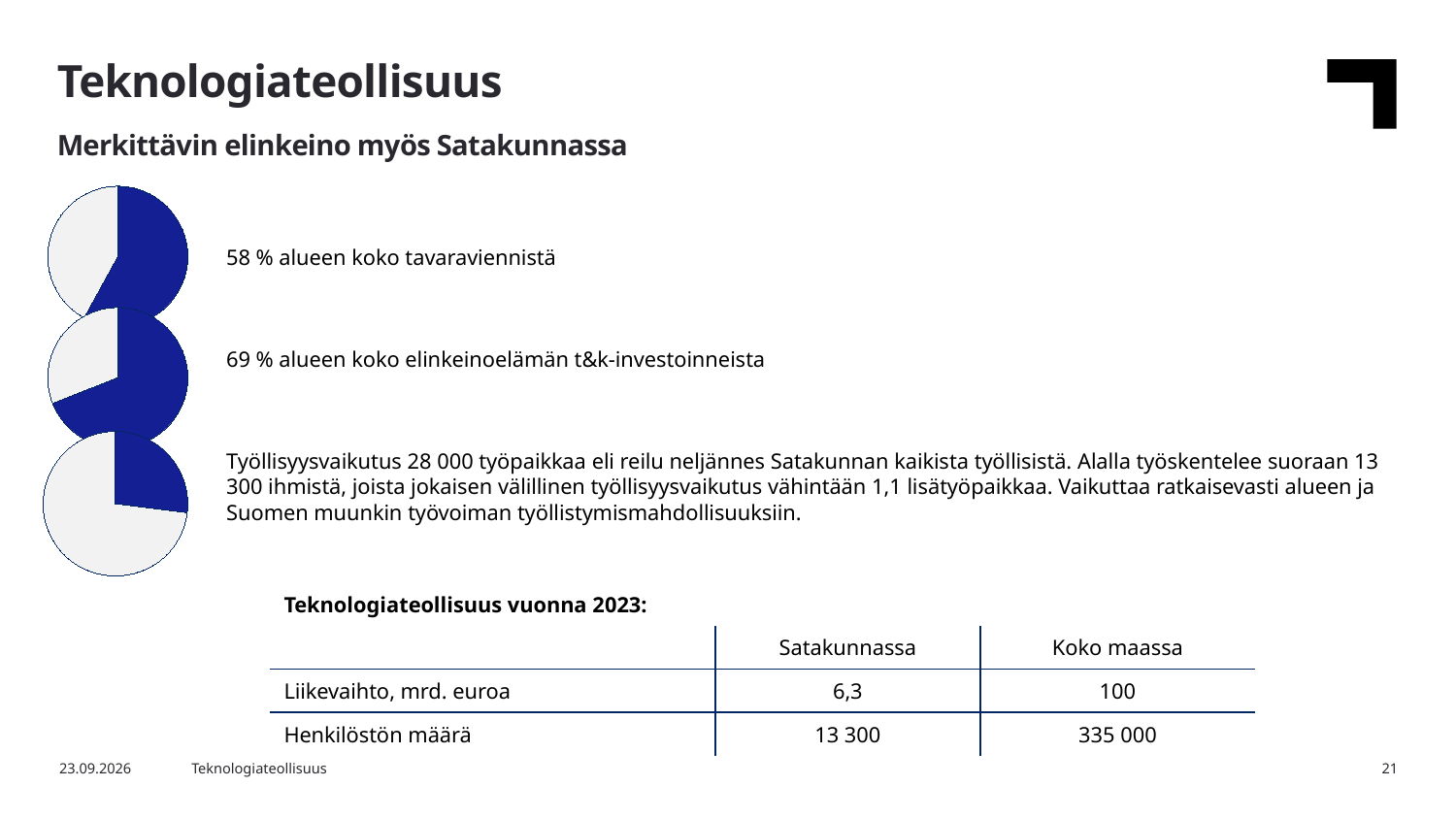
In the top pie chart, what share of the region's total goods exports does the blue slice represent, according to the text beside it? 58 % Is the blue slice in the bottom pie chart greater or less than half of the pie? less What kind of charts are shown on the left side of the slide? Pie charts Which pie chart has the largest blue slice: the top, middle or bottom one? Middle What colour is the highlighted slice in each pie chart? Blue Is the blue slice in the bottom pie chart larger or smaller than the blue slice in the top pie chart? Smaller How many slices does each pie chart have? 2 Is the blue slice in the middle pie chart larger or smaller than the blue slice in the top pie chart? Larger In the middle pie chart, what share of the region's business R&D investments does the blue slice represent, according to the text beside it? 69 % Is the blue slice in the middle pie chart greater or less than half of the pie? greater Which pie chart has the smallest blue slice: the top, middle or bottom one? Bottom How many pie charts are on the slide? 3